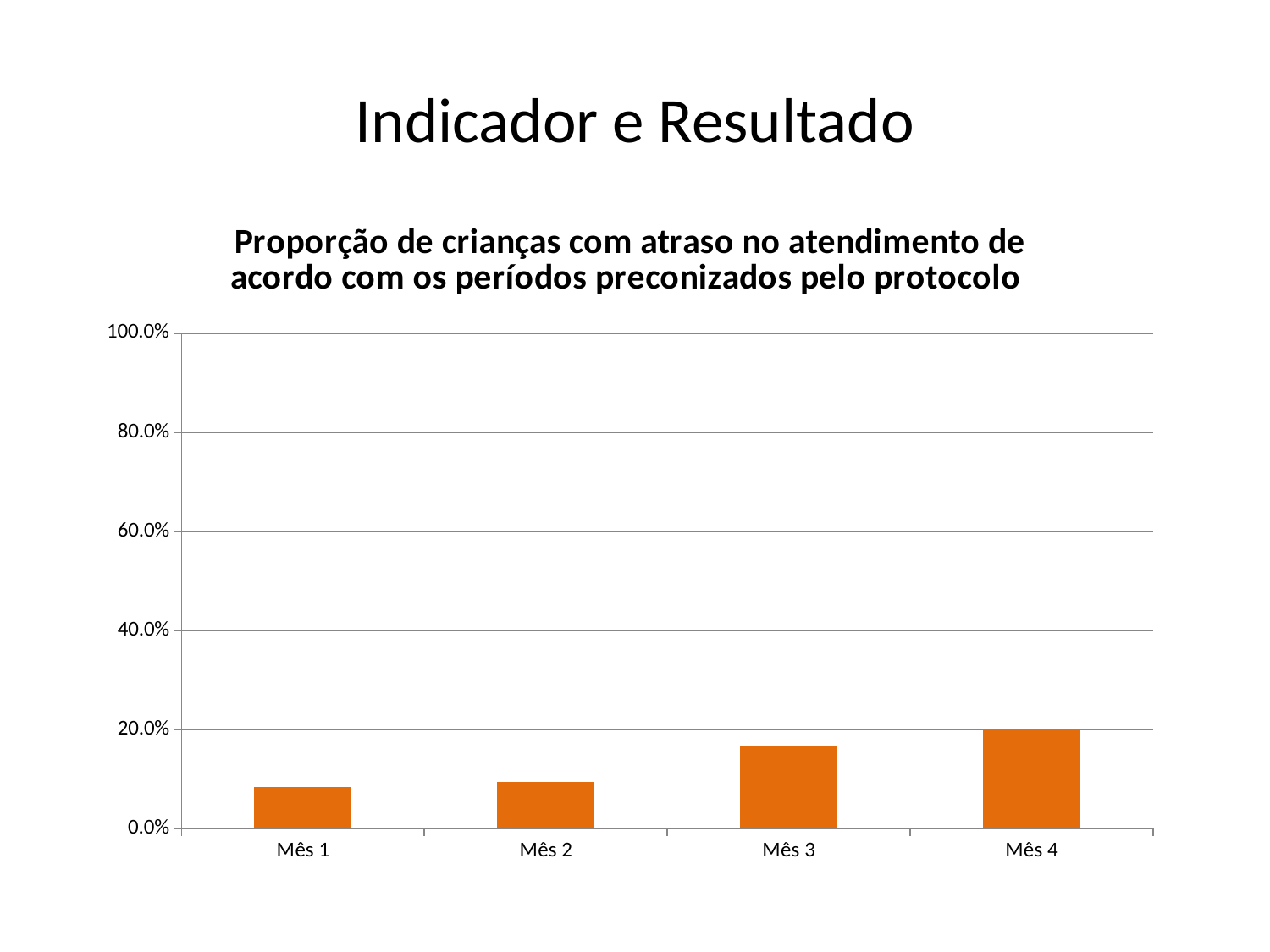
Which is larger, the value for Mês 2 or the value for Mês 4? Mês 4 Which month has the highest proportion of children with delayed care? Mês 4 What kind of chart is shown on the slide? bar chart Do the values rise or fall from Mês 1 to Mês 4? rise Is the value for Mês 3 greater or less than 20.0%? less Is the value for Mês 2 greater or less than 40.0%? less Is the value for Mês 4 greater or less than 40.0%? less What colour are the bars in the chart? orange How many categories (months) are shown on the x axis of the chart? 4 What is the title of the chart? Proporção de crianças com atraso no atendimento de acordo com os períodos preconizados pelo protocolo Which is larger, the value for Mês 1 or the value for Mês 3? Mês 3